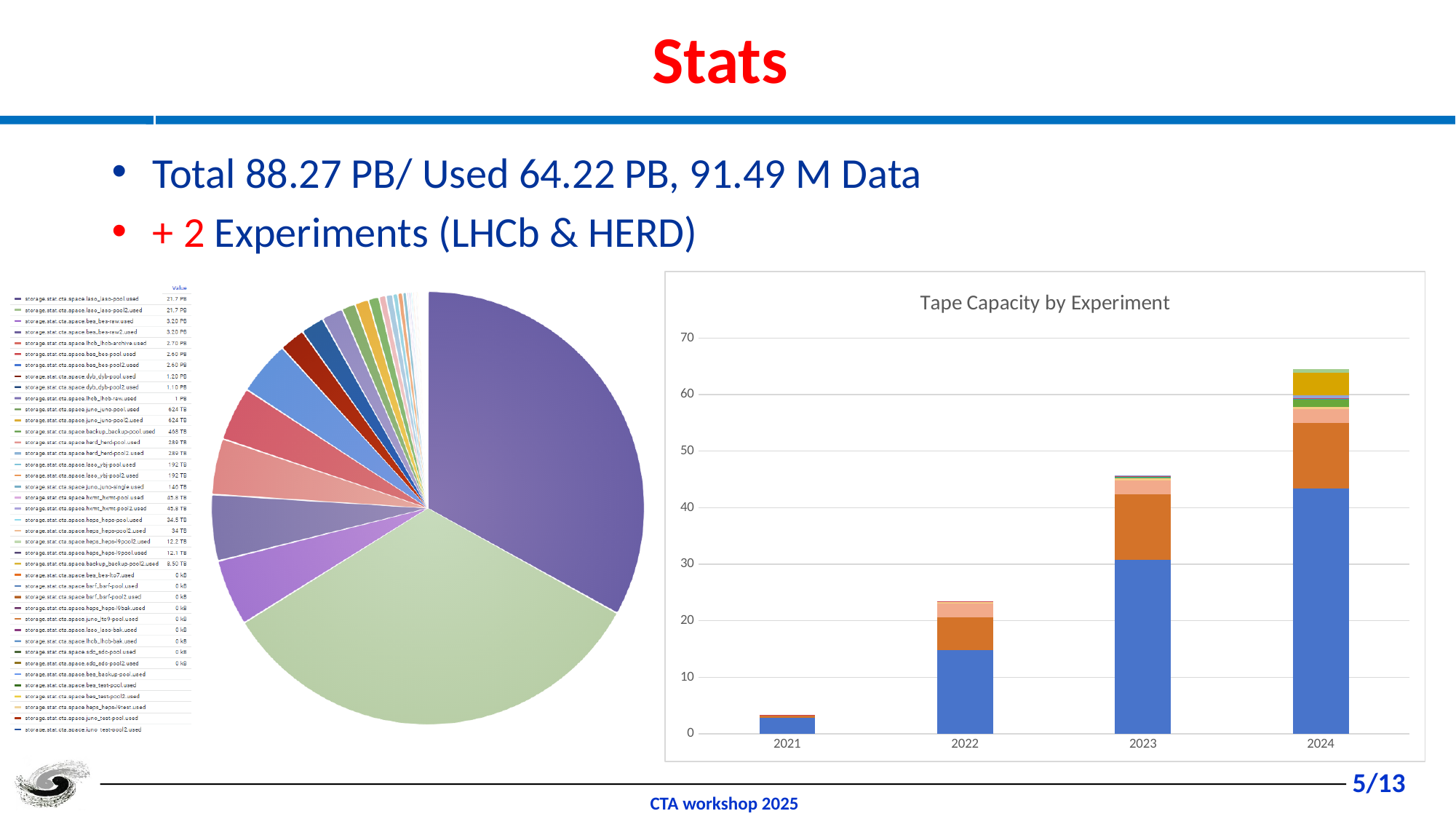
In the 'Tape Capacity by Experiment' chart, which year has the larger stacked bar, 2022 or 2023? 2023 In the 'Tape Capacity by Experiment' chart, is the total for 2023 greater or less than 40? greater In the 'Tape Capacity by Experiment' chart, do the stacked bar totals rise or fall from 2021 to 2024? rise In the 'Tape Capacity by Experiment' chart, how many years are shown on the x axis? 4 In the 'Tape Capacity by Experiment' chart, which year has the shortest stacked bar? 2021 In the 'Tape Capacity by Experiment' chart, is the total for 2022 greater or less than 30? less In the 'Tape Capacity by Experiment' chart, is the total for 2024 greater or less than 60? greater What kind of chart is the 'Tape Capacity by Experiment' chart on the right? bar chart What is the title of the bar chart on the right of the slide? Tape Capacity by Experiment In the 'Tape Capacity by Experiment' chart, which year has the tallest stacked bar? 2024 What kind of chart is the chart on the left of the slide? pie chart